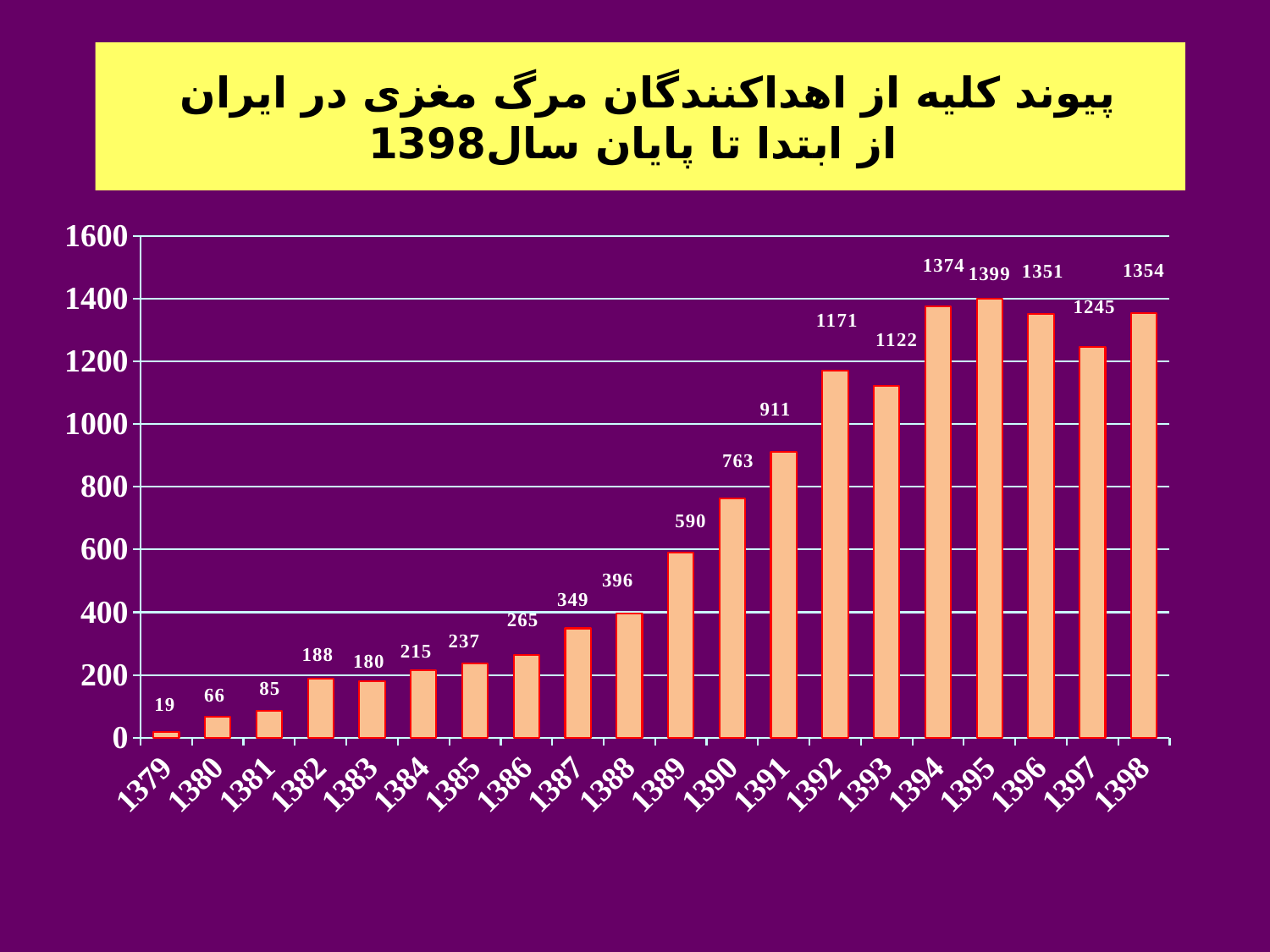
What type of chart is shown on the slide? bar chart What is the value for the year 1394? 1374 What is the value for the year 1389? 590 Overall, do the values rise or fall from 1379 to 1395? rise Which year has the highest value? 1395 Which is larger, the value for 1396 or the value for 1398? 1398 What is the difference between the values for 1392 and 1393? 49 What is the difference between the values for 1398 and 1397? 109 Which year has the lowest value? 1379 How many years (categories) are plotted on the chart? 20 Is the value for 1391 greater or less than 1000? less What is the value for the year 1383? 180